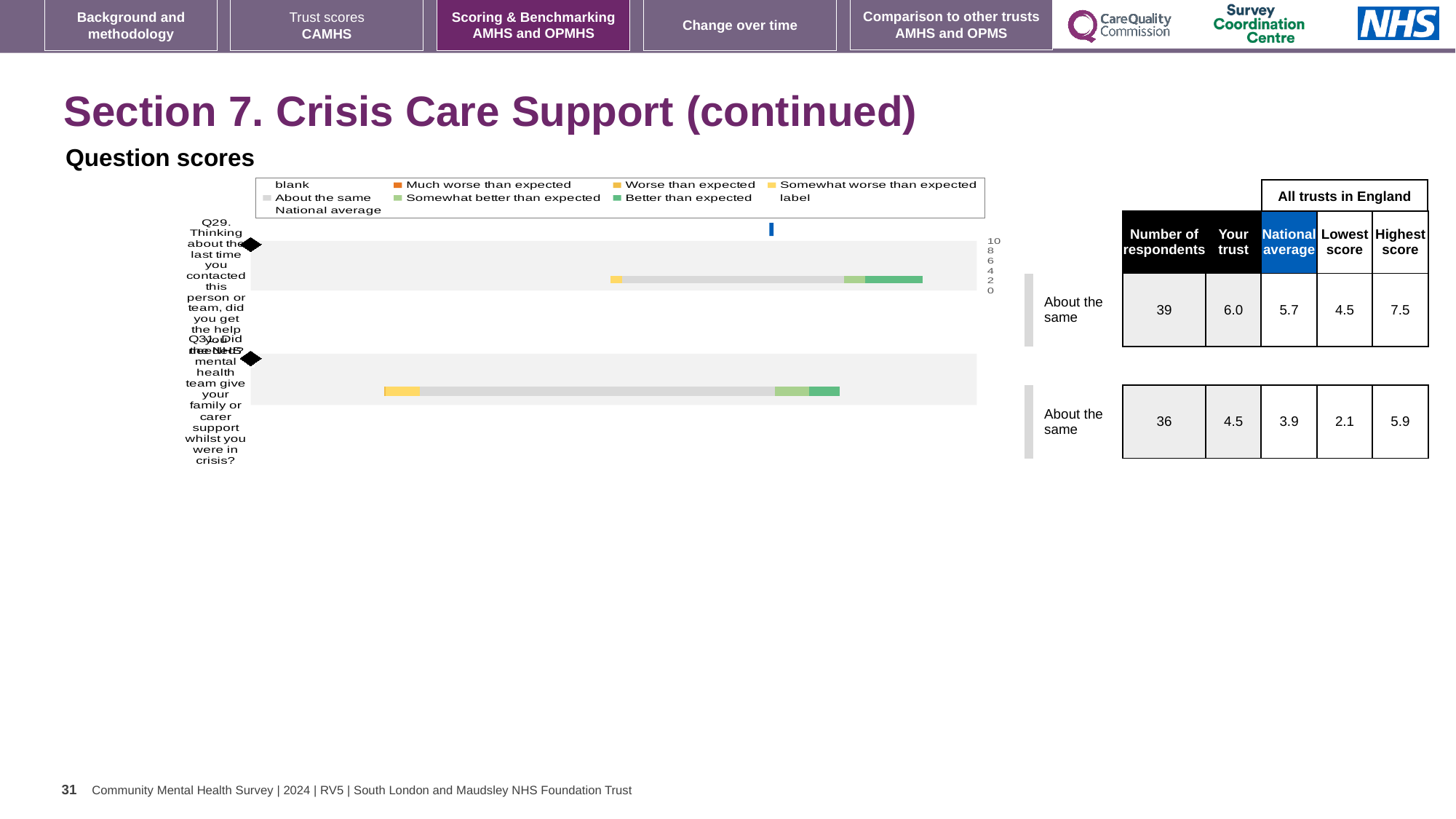
What kind of chart is shown under 'Question scores'? bar chart In the table beside the chart, how many respondents answered Q31? 36 Which legend entry in the chart is shown in orange? Much worse than expected In the table beside the chart, what is the highest score for Q31? 5.9 In the table beside the chart, what is the 'Your trust' score for Q29? 6.0 Which legend entry in the chart is shown in dark green? Better than expected In the table beside the chart, what is the difference between the highest and lowest score for Q29? 3.0 Which question has the higher 'Your trust' score in the table beside the chart, Q29 or Q31? Q29 In the table beside the chart, what is the national average for Q29? 5.7 How many questions (categories) are plotted in the chart? 2 In the table beside the chart, what is the 'Your trust' score for Q31? 4.5 In the table beside the chart, what is the difference between the 'Your trust' score and the national average for Q31? 0.6